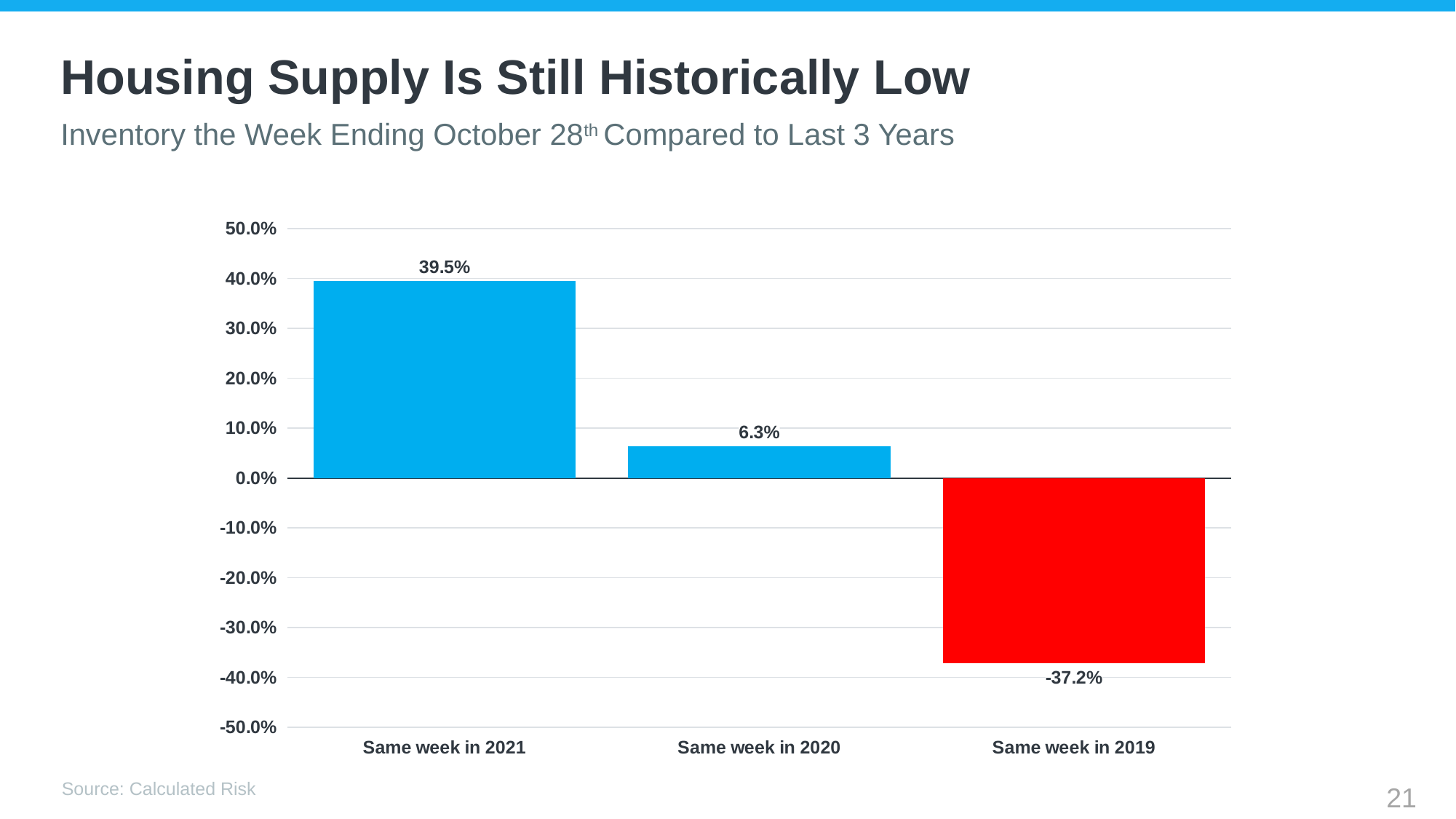
How many categories are shown on the x axis? 3 What is the value for Same week in 2021? 39.5% What is the value for Same week in 2019? -37.2% Do the values rise or fall from left to right along the x axis? fall What kind of chart is shown on the slide? bar chart What is the difference between the values for Same week in 2021 and Same week in 2020? 33.2% Which category has the lowest value? Same week in 2019 Is the value for Same week in 2021 greater or less than 30.0%? greater Which category has the highest value? Same week in 2021 What colour is the bar for Same week in 2019? red What is the value for Same week in 2020? 6.3% Which is larger, the value for Same week in 2020 or Same week in 2019? Same week in 2020